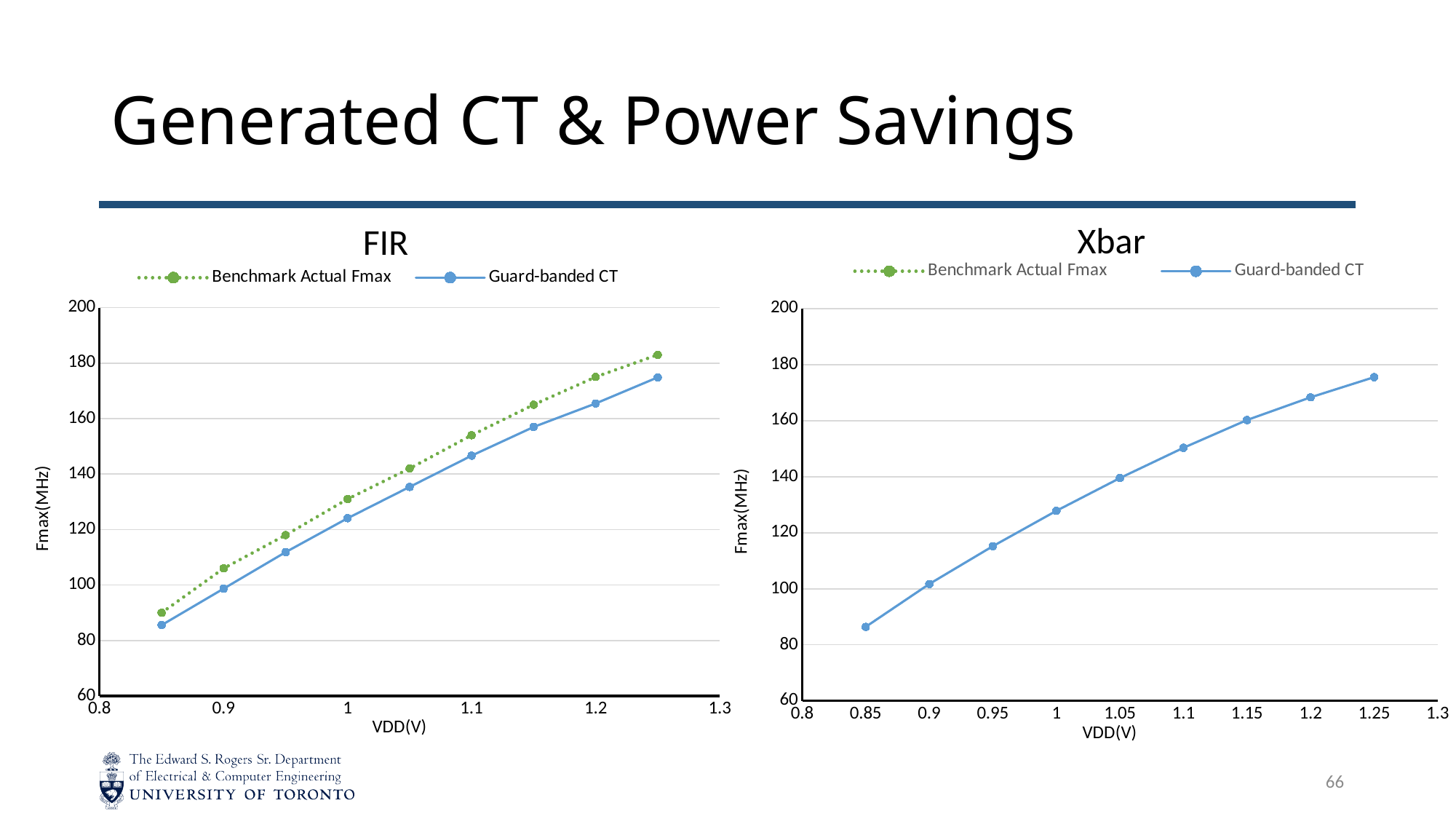
In the FIR chart, at which VDD value does the Benchmark Actual Fmax series reach its highest point? 1.25 In the Xbar chart, is the Guard-banded CT value at VDD 0.85 greater or less than 100? less In the FIR chart, is the Benchmark Actual Fmax value at VDD 1.25 greater or less than 180? greater In the Xbar chart, is the Guard-banded CT value at VDD 1.2 greater or less than 160? greater What is the y-axis label of the Xbar chart? Fmax(MHz) In the FIR chart, do the Fmax values rise or fall as VDD increases? rise In the FIR chart, which series is higher at VDD 1.0, Benchmark Actual Fmax or Guard-banded CT? Benchmark Actual Fmax How many data points does the Guard-banded CT series have in the Xbar chart? 9 How many series does the legend of the FIR chart list? 2 What kind of chart is the FIR chart? line chart